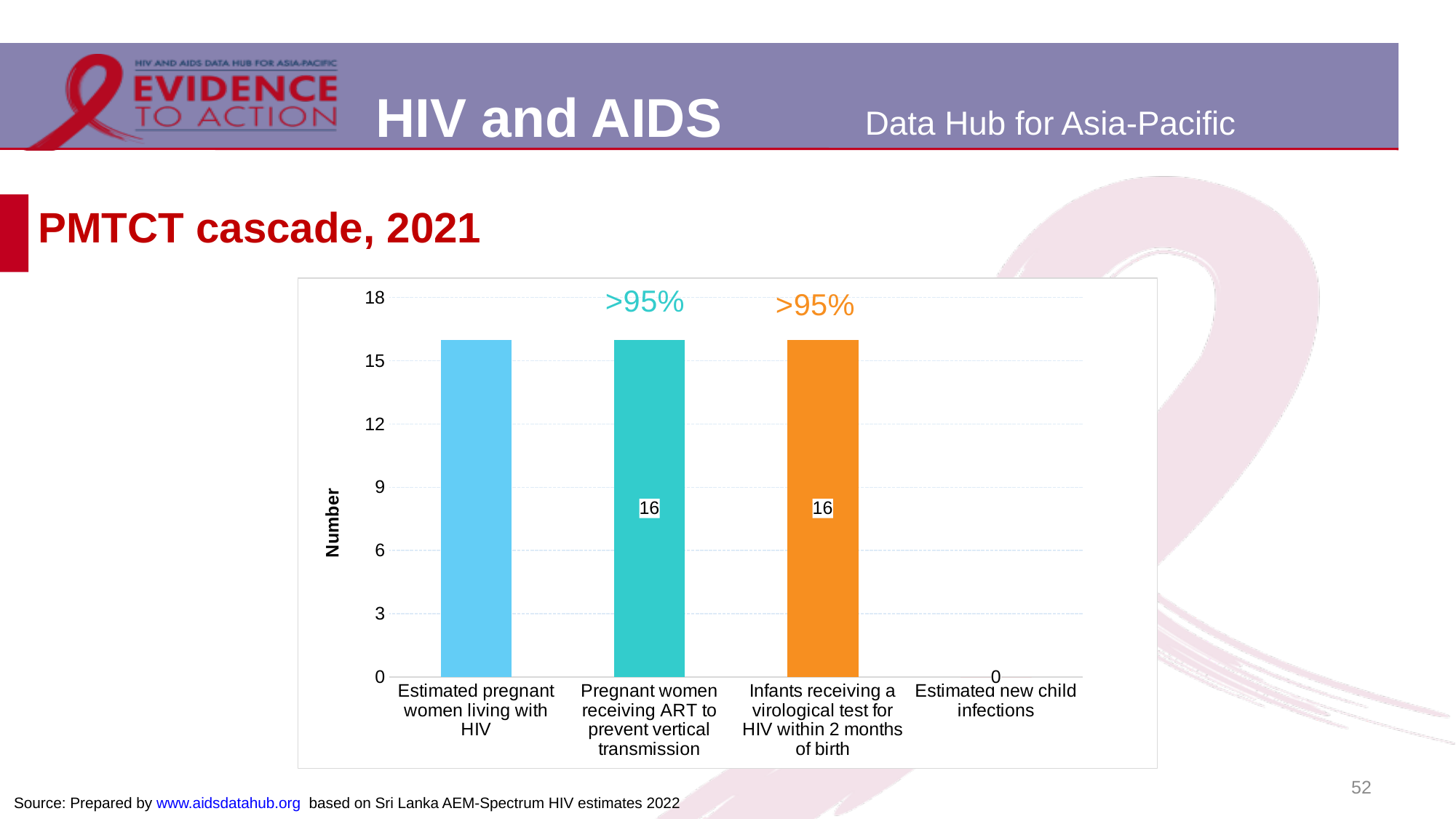
What is the value for Estimated new child infections? 0 Which category has the lowest value? Estimated new child infections What kind of chart is shown on the slide? Bar chart What is the title of the y axis? Number What is the value for Infants receiving a virological test for HIV within 2 months of birth? 16 How many categories are shown on the x axis? 4 Is the value for Estimated pregnant women living with HIV greater or less than 12? greater Which is larger: the value for Infants receiving a virological test for HIV within 2 months of birth or the value for Estimated new child infections? Infants receiving a virological test for HIV within 2 months of birth What percentage label is shown above the bar for Infants receiving a virological test for HIV within 2 months of birth? >95% What is the difference between the value for Pregnant women receiving ART to prevent vertical transmission and the value for Estimated new child infections? 16 What is the value for Pregnant women receiving ART to prevent vertical transmission? 16